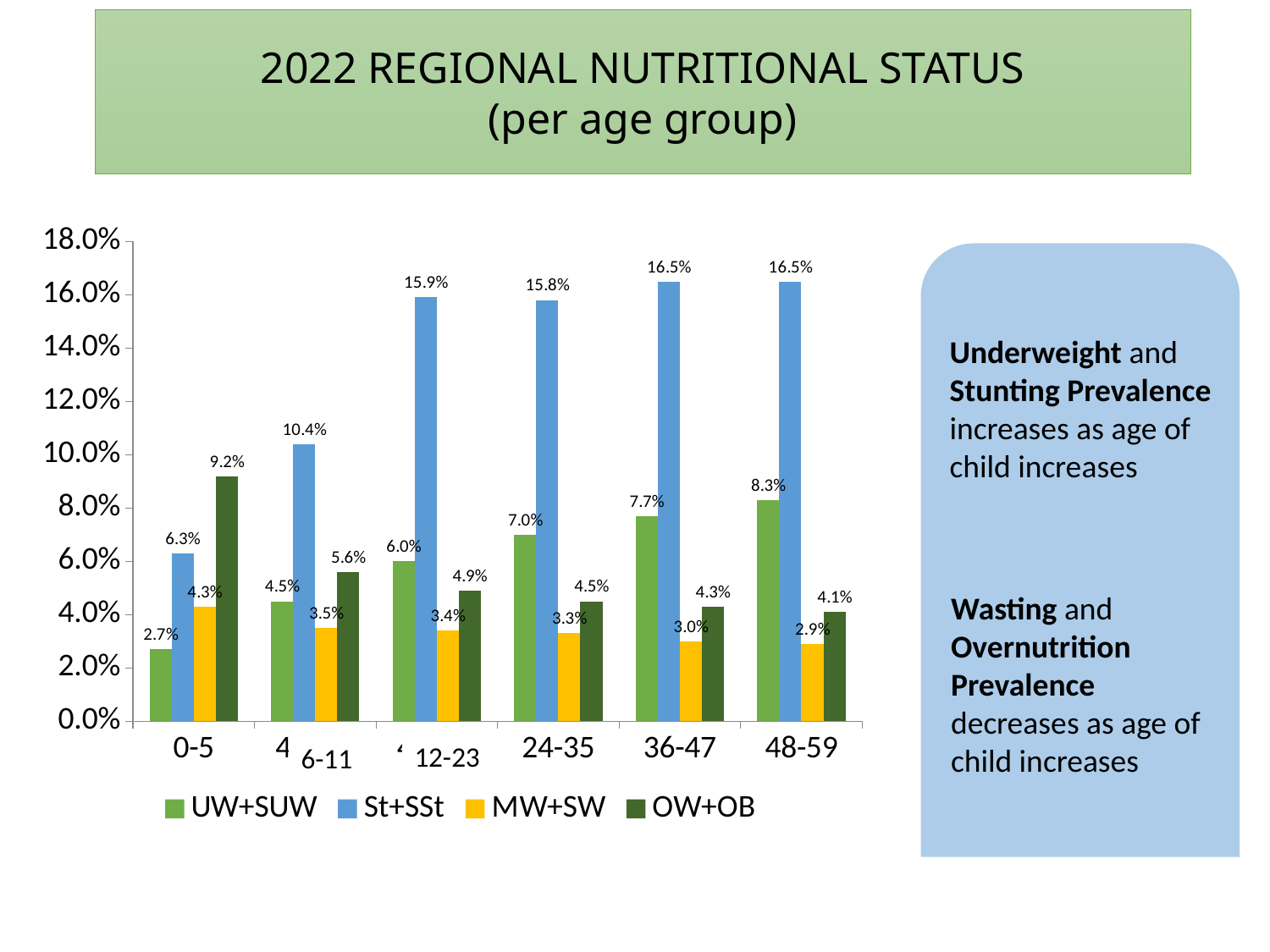
How many age groups are shown on the x axis? 6 Which age group has the highest OW+OB value? 0-5 How many series does the legend list? 4 What kind of chart is shown on the slide? bar chart Which age group has the lowest MW+SW value? 48-59 Is the St+SSt value for the 24-35 age group greater or less than 14.0%? greater What is the OW+OB value for the 0-5 age group? 9.2% Do the UW+SUW values rise or fall as the age group increases along the x axis? rise Which is larger: the UW+SUW value for 24-35 or the UW+SUW value for 36-47? 36-47 What is the UW+SUW value for the 48-59 age group? 8.3% What is the St+SSt value for the 12-23 age group? 15.9% What is the difference between the St+SSt values for the 6-11 and 0-5 age groups? 4.1%